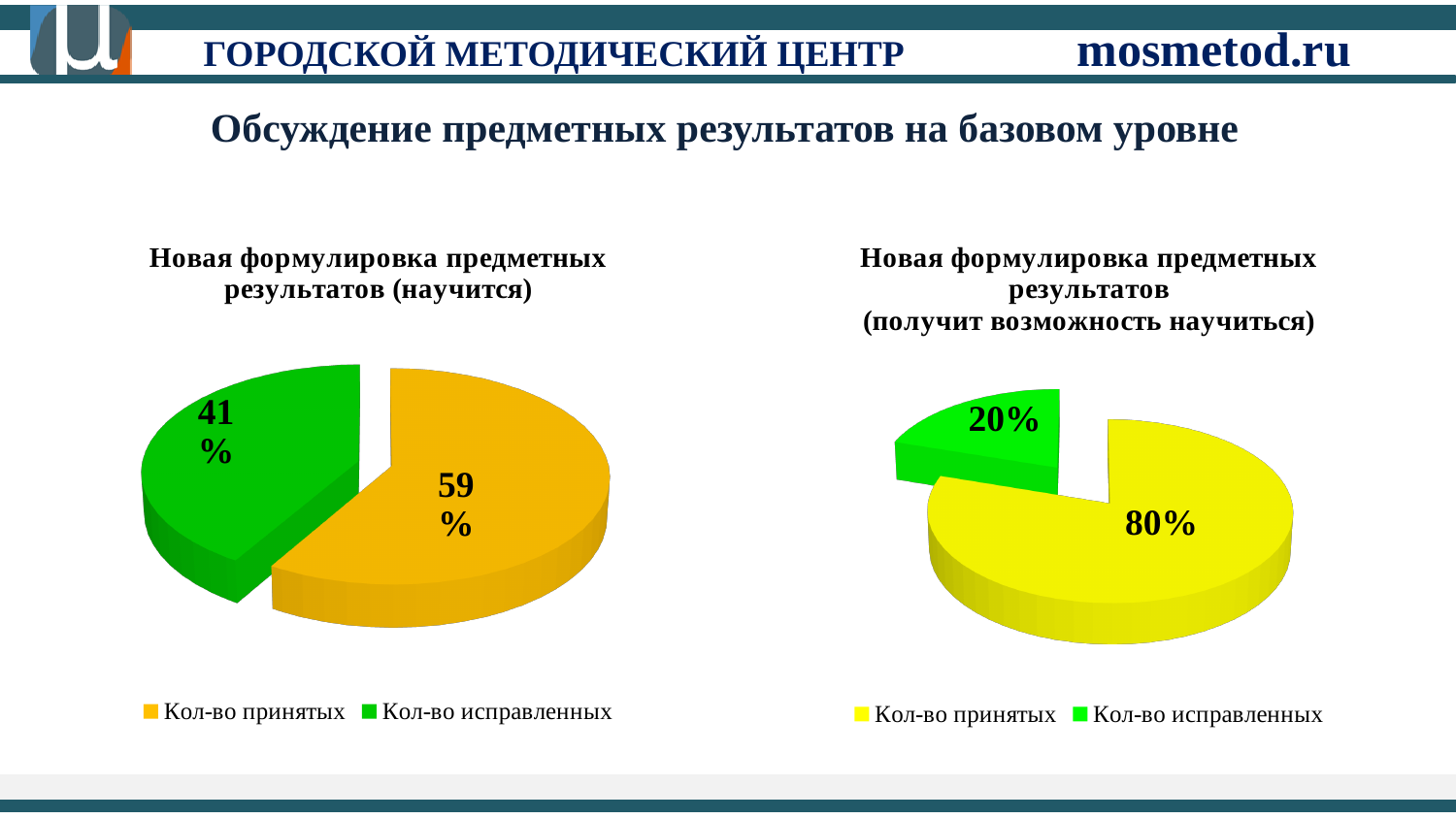
In the left chart (научится), which category has the larger share? Кол-во принятых In the right chart (получит возможность научиться), what is the difference in percentage points between Кол-во принятых and Кол-во исправленных? 60 Is the share of Кол-во исправленных larger in the left chart (научится) or in the right chart (получит возможность научиться)? Left chart (научится) In the left chart (Новая формулировка предметных результатов (научится)), what share is labelled for Кол-во исправленных? 41% In the right chart (получит возможность научиться), what share is labelled for Кол-во принятых? 80% What colour is the Кол-во принятых slice in the left chart (научится)? Orange What type of chart is used on the left (научится)? Pie chart In the right chart (получит возможность научиться), which category has the smaller share? Кол-во исправленных How many slices does the right chart (получит возможность научиться) have? 2 In the left chart (научится), what is the difference in percentage points between Кол-во принятых and Кол-во исправленных? 18 In the left chart (Новая формулировка предметных результатов (научится)), what share is labelled for Кол-во принятых? 59% In the right chart (получит возможность научиться), what share is labelled for Кол-во исправленных? 20%